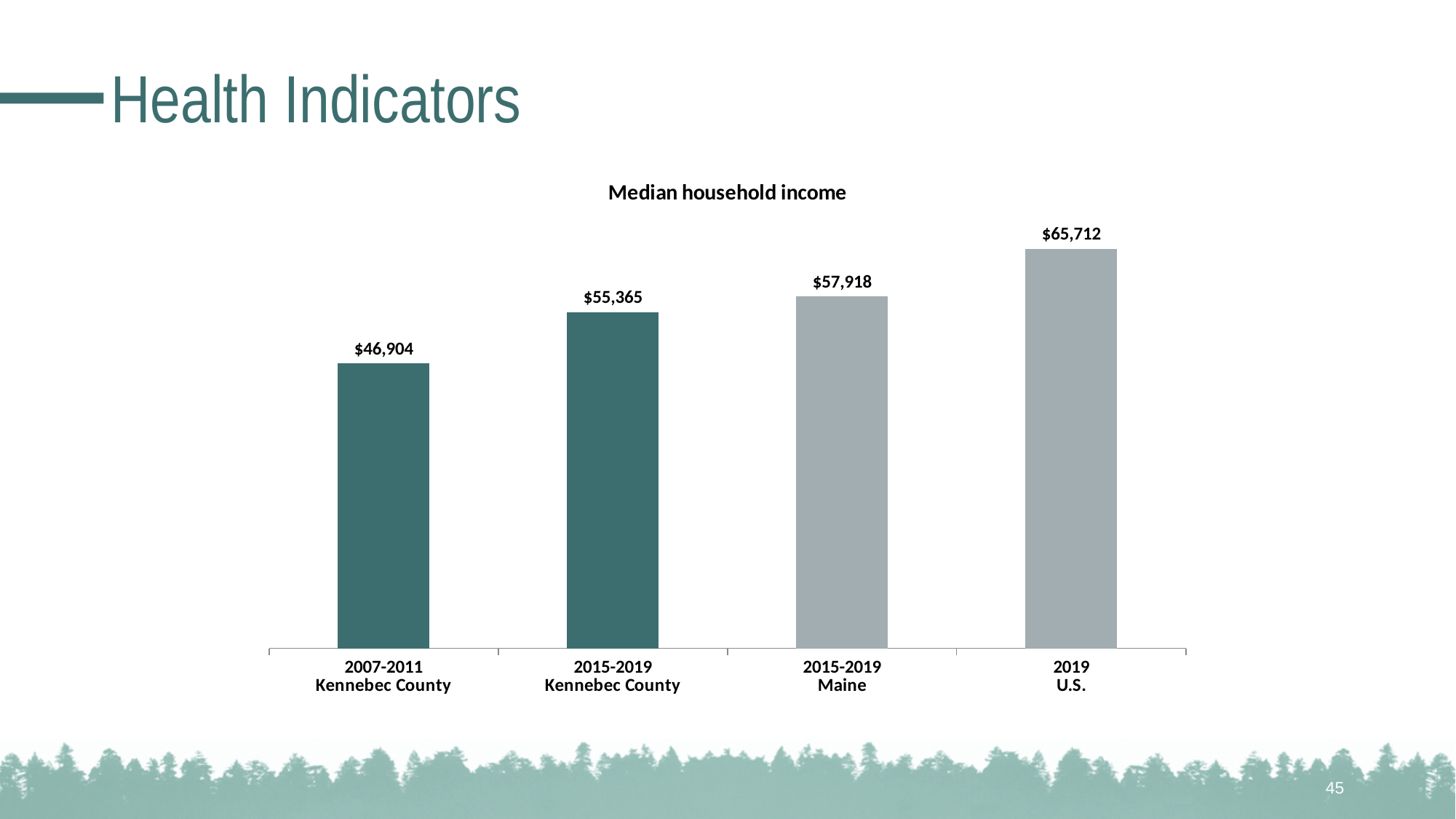
What is the difference between the 2015-2019 and 2007-2011 median household income for Kennebec County? $8,461 What is the median household income for the U.S. in 2019? $65,712 What is the title of the chart? Median household income How many bars are shown in the chart? 4 What is the median household income for Maine in 2015-2019? $57,918 Which category has the lowest median household income? 2007-2011 Kennebec County What is the median household income for Kennebec County in 2007-2011? $46,904 Which is larger, the 2015-2019 median household income for Kennebec County or for Maine? Maine What is the difference between the 2019 U.S. median household income and the 2015-2019 Maine median household income? $7,794 What kind of chart is shown on the slide? Bar chart What is the median household income for Kennebec County in 2015-2019? $55,365 Which category has the highest median household income? 2019 U.S.